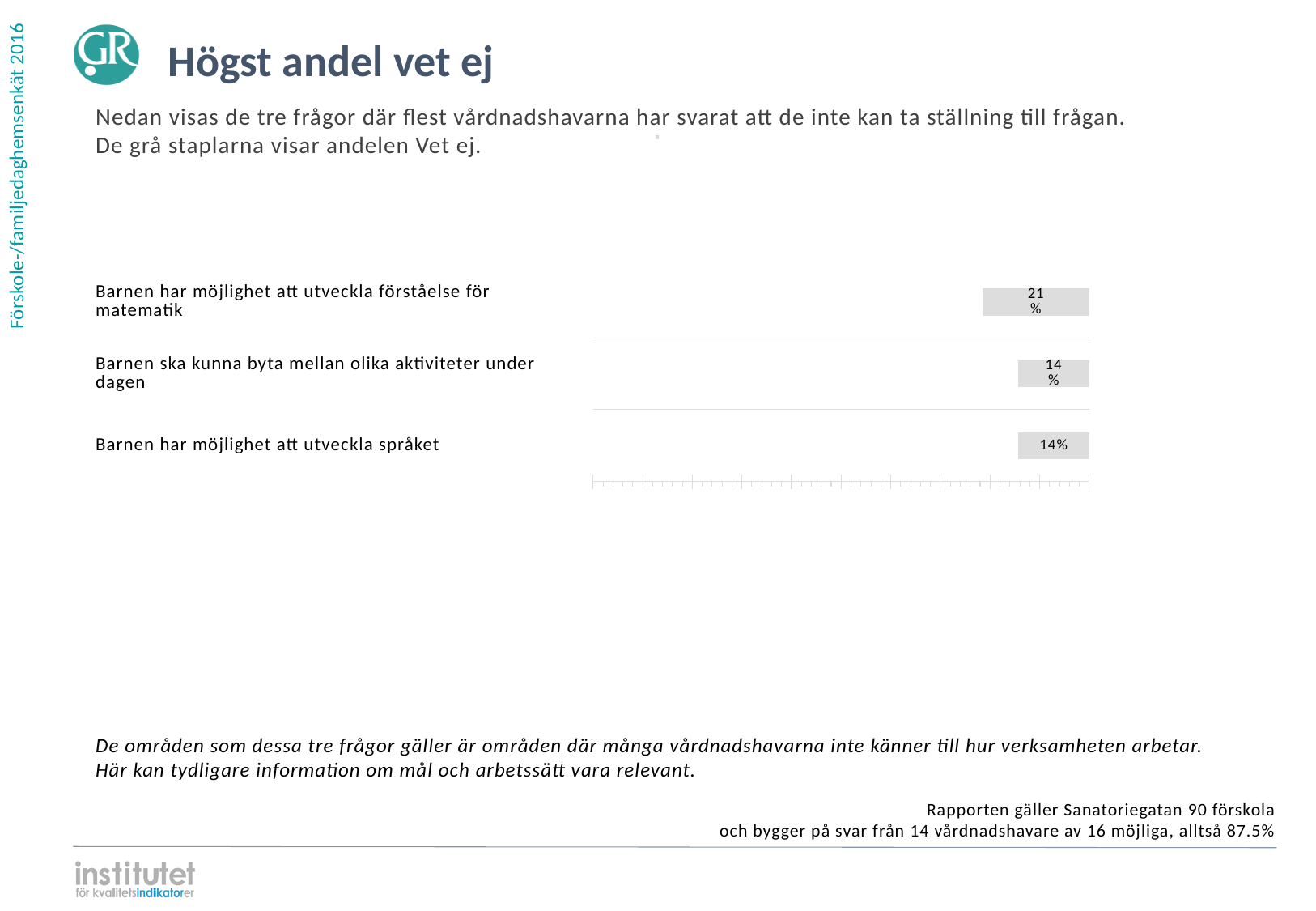
How many categories share the same value of 14%? 2 Which category has the highest share of "Vet ej"? Barnen har möjlighet att utveckla förståelse för matematik What is the title of the slide containing the chart? Högst andel vet ej How many categories are shown in the chart? 3 What is the value for "Barnen har möjlighet att utveckla förståelse för matematik"? 21% What colour are the bars in the chart? Grey What is the value for "Barnen ska kunna byta mellan olika aktiviteter under dagen"? 14% What is the value for "Barnen har möjlighet att utveckla språket"? 14% Which is larger: the value for "Barnen har möjlighet att utveckla förståelse för matematik" or the value for "Barnen ska kunna byta mellan olika aktiviteter under dagen"? Barnen har möjlighet att utveckla förståelse för matematik What kind of chart is shown on the slide? Bar chart What is the difference between the value for "Barnen har möjlighet att utveckla förståelse för matematik" and the value for "Barnen har möjlighet att utveckla språket"? 7 percentage points